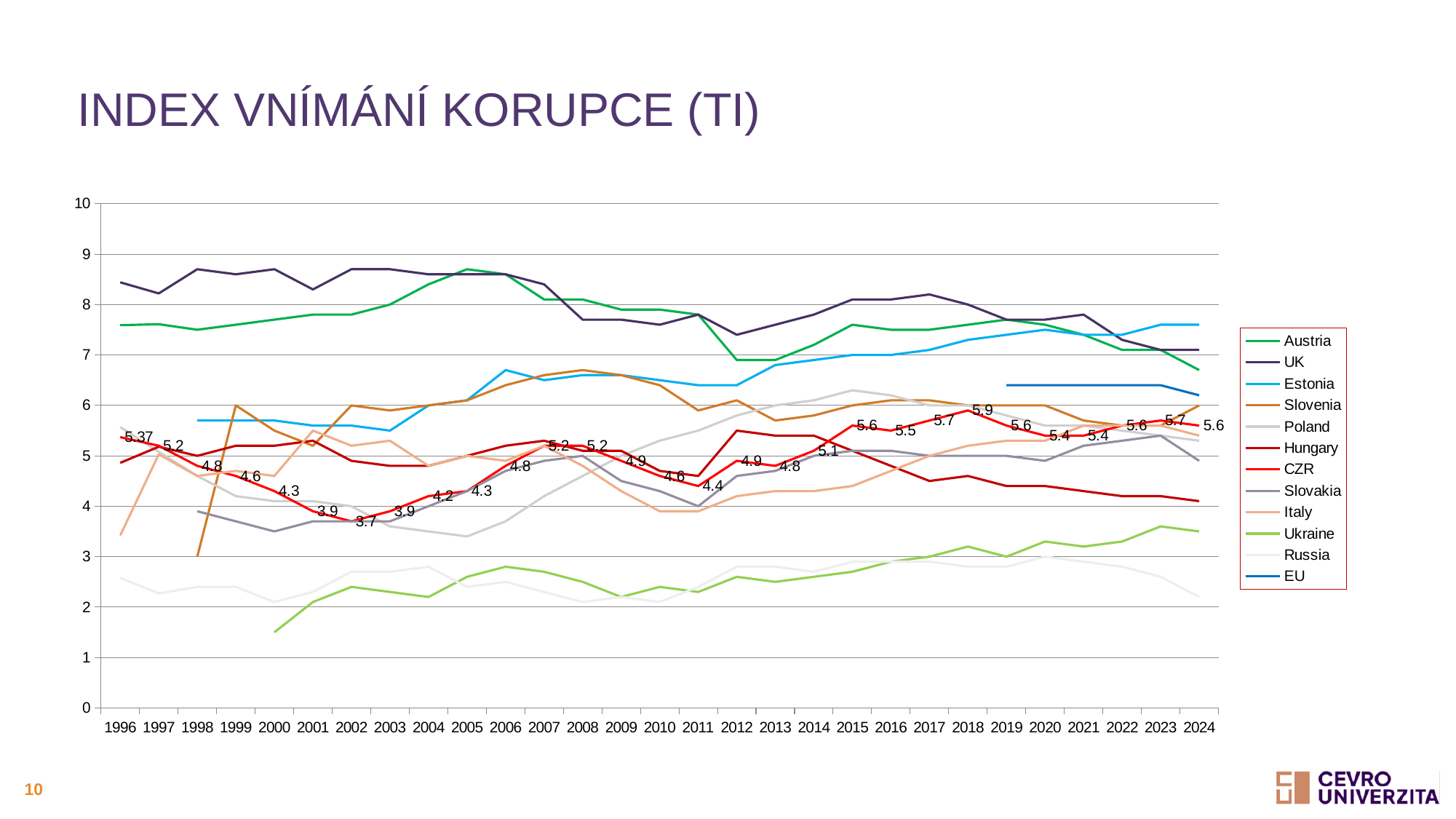
Is the value for UK in 1996 greater or less than 8? greater Does the Ukraine series generally rise or fall from 2000 to 2024? rise How many years are shown on the x axis? 29 What kind of chart is shown on the slide? line chart Is the value for Ukraine in 2000 greater or less than 2? less How many series does the legend list? 12 What is the difference between the highest printed data label (2018) and the lowest printed data label (2002)? 2.2 What is the data label shown at 1996 on the series that carries data labels? 5.37 What is the data label shown at 2018 on the series that carries data labels? 5.9 Which series has the highest value in 2024? Estonia What is the lowest data label printed on the chart, and in which year does it occur? 3.7 in 2002 What is the title of the chart? INDEX VNÍMÁNÍ KORUPCE (TI)